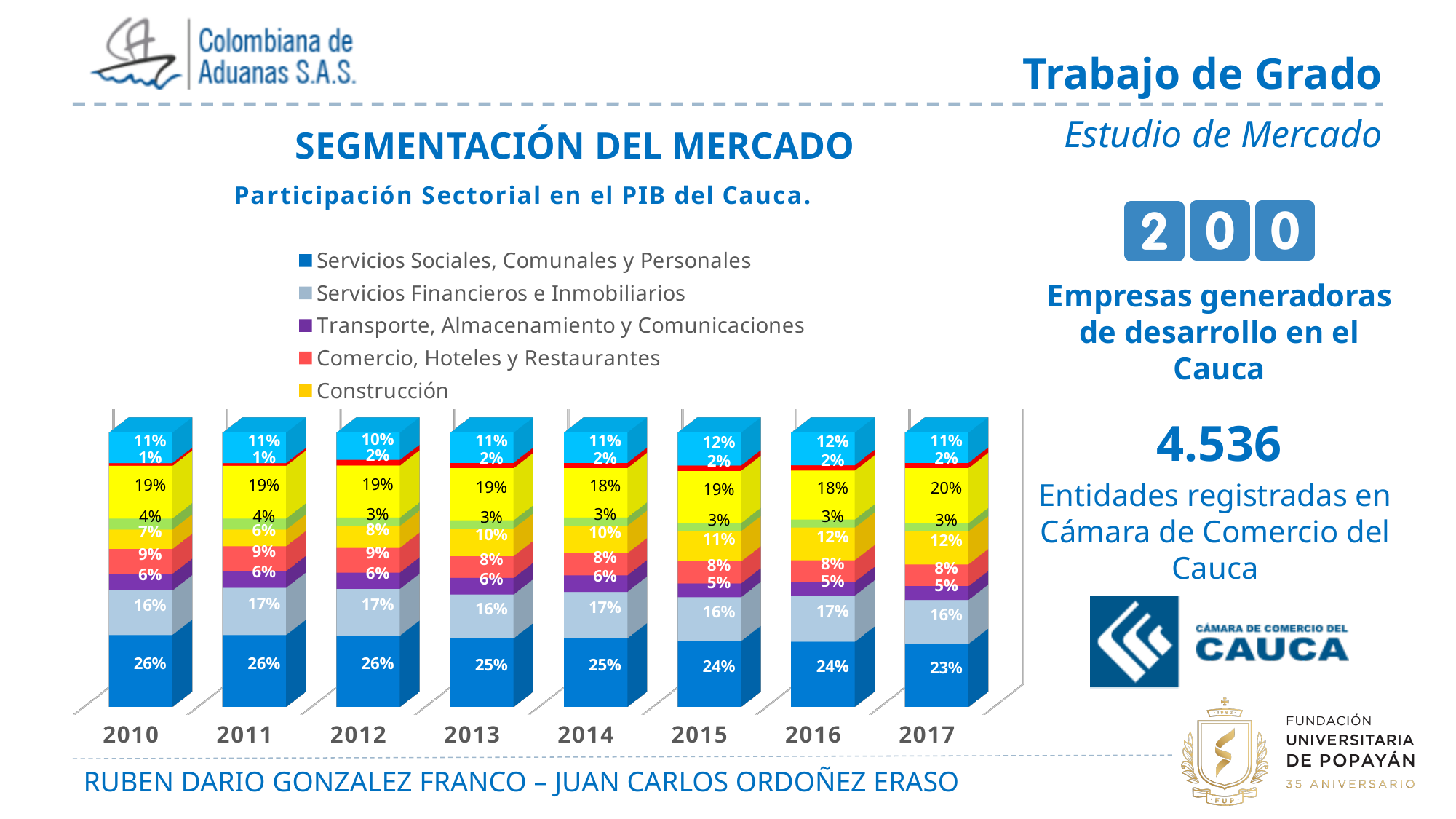
How many series does the chart legend list? 5 Which year has the larger value for Transporte, Almacenamiento y Comunicaciones, 2010 or 2017? 2010 What is the value for Comercio, Hoteles y Restaurantes in 2012? 9% What is the value for Construcción in 2017? 12% Does the value for Construcción rise or fall from 2010 to 2017? Rise What is the value for Servicios Financieros e Inmobiliarios in 2014? 17% How many years are shown along the x axis of the chart? 8 In which year is the value for Construcción lowest? 2011 What is the value for Servicios Sociales, Comunales y Personales in 2010? 26% In which year is the value for Servicios Sociales, Comunales y Personales lowest? 2017 What kind of chart is shown on the slide? Stacked bar chart By how many percentage points does Servicios Sociales, Comunales y Personales differ between 2010 and 2017? 3 percentage points